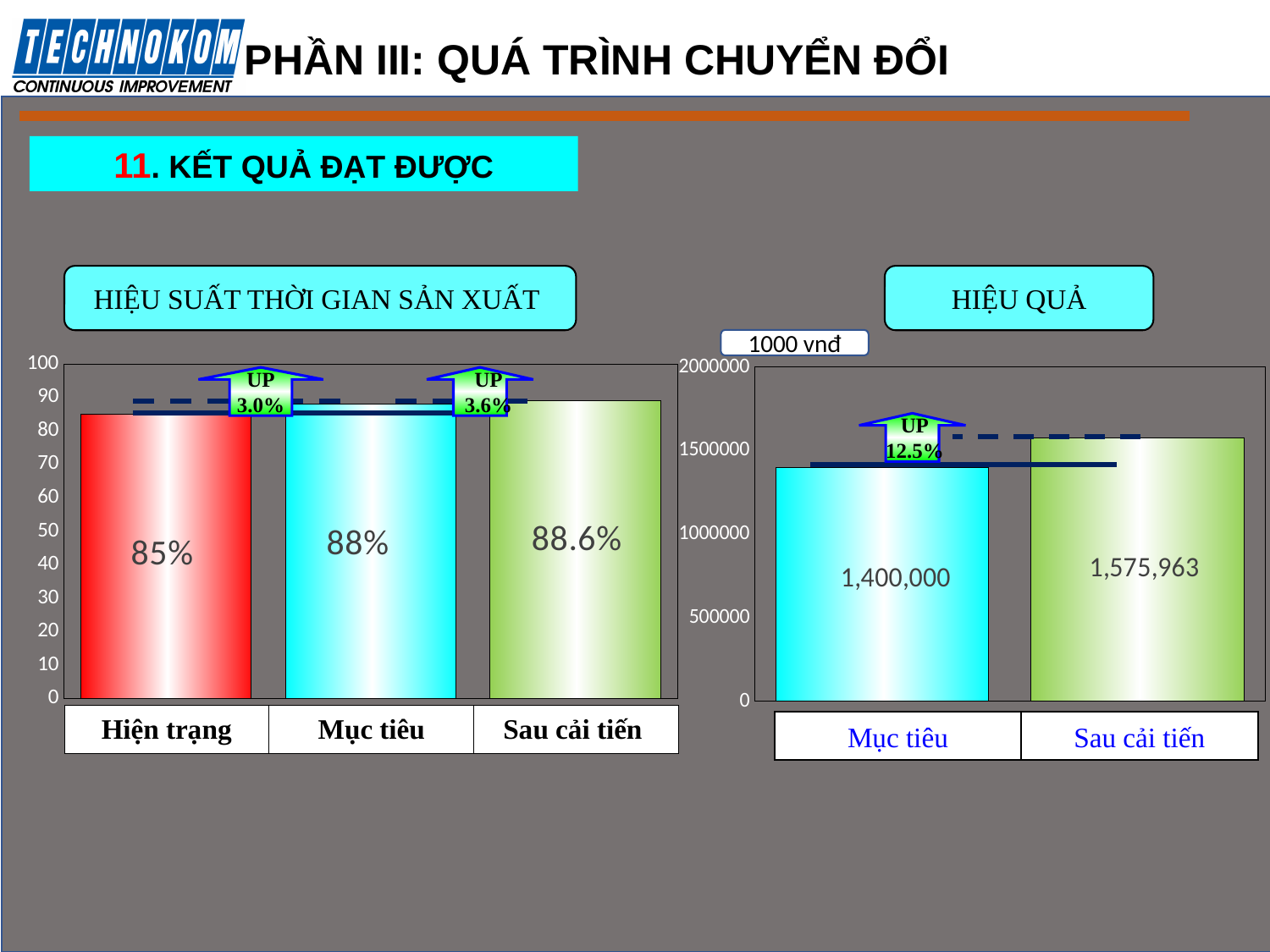
In the HIỆU SUẤT THỜI GIAN SẢN XUẤT chart, do the values rise or fall from left to right? rise In the HIỆU QUẢ chart, which category has the higher value? Sau cải tiến In the HIỆU SUẤT THỜI GIAN SẢN XUẤT chart, what is the difference between Mục tiêu and Hiện trạng? 3% What unit is shown above the HIỆU QUẢ chart? 1000 vnđ In the HIỆU QUẢ chart, what is the value for Mục tiêu? 1,400,000 In the HIỆU SUẤT THỜI GIAN SẢN XUẤT chart, how many categories are shown? 3 In the HIỆU QUẢ chart, what is the difference between Sau cải tiến and Mục tiêu? 175,963 In the HIỆU SUẤT THỜI GIAN SẢN XUẤT chart, what is the value for Sau cải tiến? 88.6% In the HIỆU QUẢ chart, what is the value for Sau cải tiến? 1,575,963 What kind of chart is the HIỆU QUẢ chart? bar chart In the HIỆU SUẤT THỜI GIAN SẢN XUẤT chart, which category has the lowest value? Hiện trạng In the HIỆU SUẤT THỜI GIAN SẢN XUẤT chart, what is the value for Hiện trạng? 85%